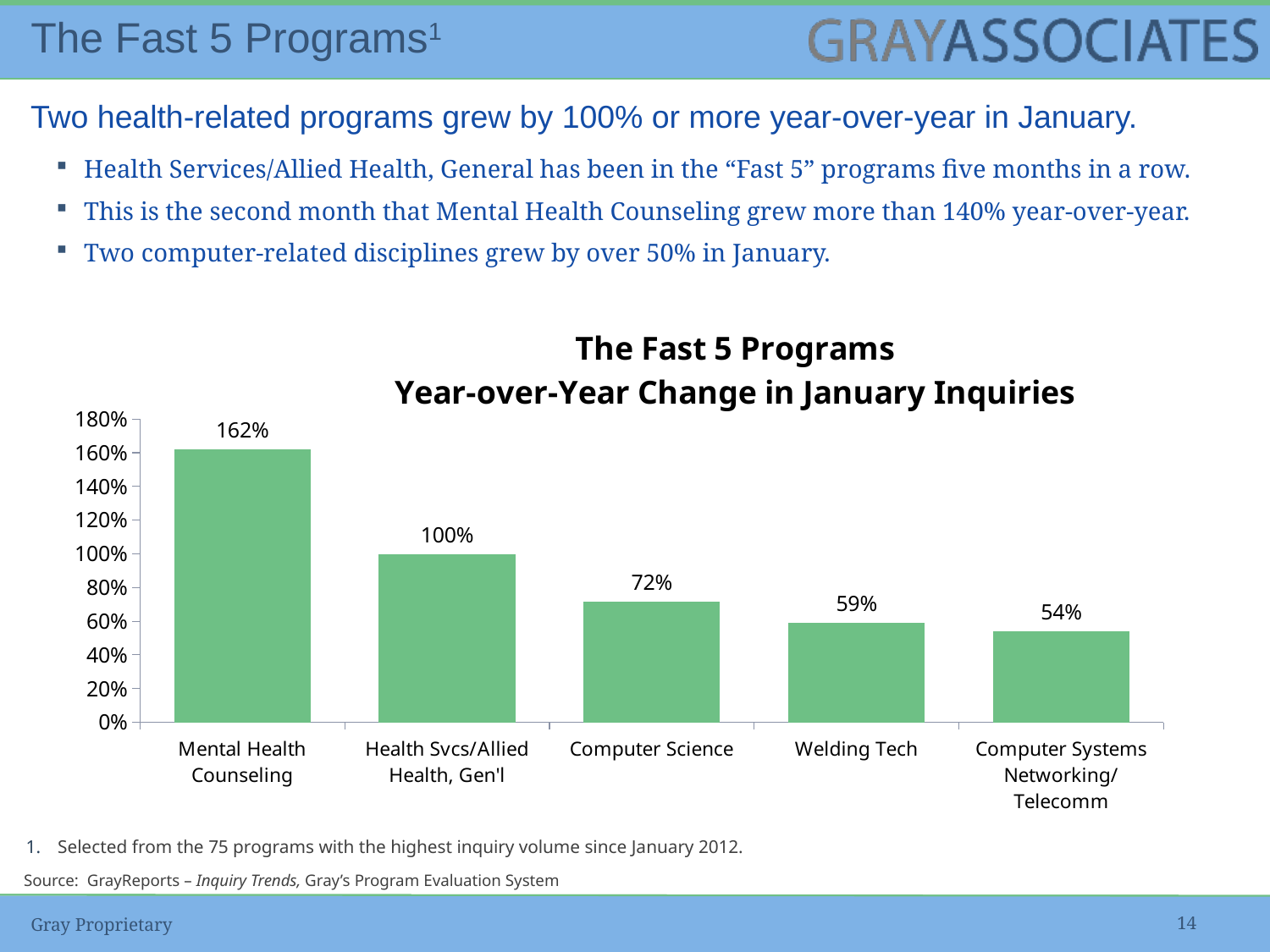
What is the year-over-year change in January inquiries for Computer Science? 72% Which program has the lowest year-over-year change in January inquiries? Computer Systems Networking/Telecomm Which program has the highest year-over-year change in January inquiries? Mental Health Counseling What kind of chart is shown on the slide? Bar chart What is the difference between the year-over-year change for Mental Health Counseling and Health Svcs/Allied Health, Gen'l? 62% What is the year-over-year change in January inquiries for Mental Health Counseling? 162% What is the year-over-year change in January inquiries for Health Svcs/Allied Health, Gen'l? 100% How many programs are shown in the chart? 5 What is the year-over-year change in January inquiries for Welding Tech? 59% Which has a larger year-over-year change in January inquiries, Computer Science or Welding Tech? Computer Science What is the title of the chart? The Fast 5 Programs Year-over-Year Change in January Inquiries What is the year-over-year change in January inquiries for Computer Systems Networking/Telecomm? 54%